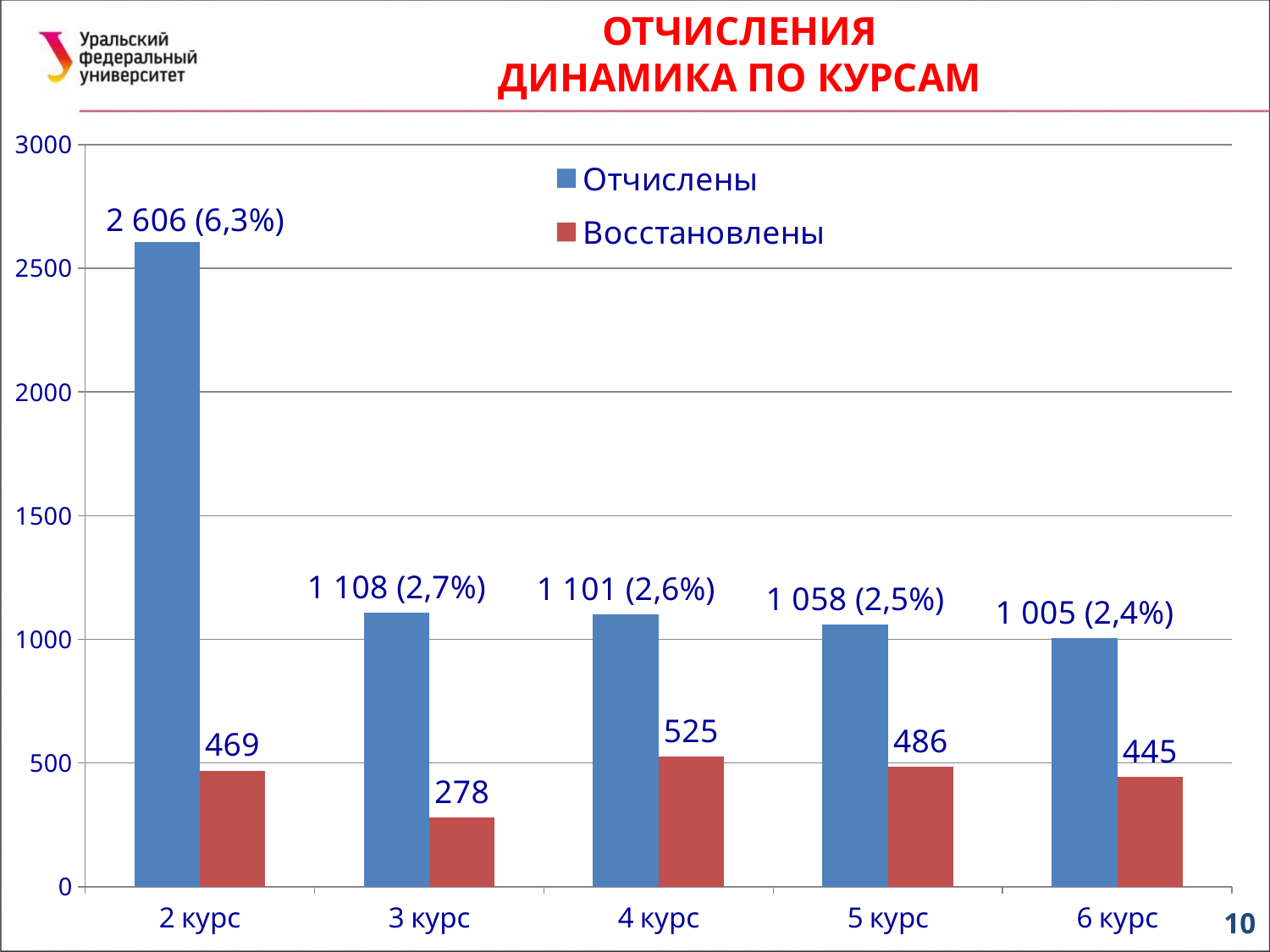
Do the Отчислены values rise or fall from 2 курс to 6 курс? fall Which course has the lowest Восстановлены value? 3 курс What is the value for Восстановлены for 3 курс? 278 How many courses are shown on the x axis? 5 How many series does the legend list? 2 Which is larger: Восстановлены for 2 курс or for 5 курс? 5 курс What is the difference between the Восстановлены values for 4 курс and 3 курс? 247 What is the value for Отчислены for 2 курс? 2 606 (6,3%) What is the value for Отчислены for 6 курс? 1 005 (2,4%) Which course has the highest Отчислены value? 2 курс Is the Отчислены value for 5 курс greater or less than 1000? greater What kind of chart is shown on the slide? bar chart